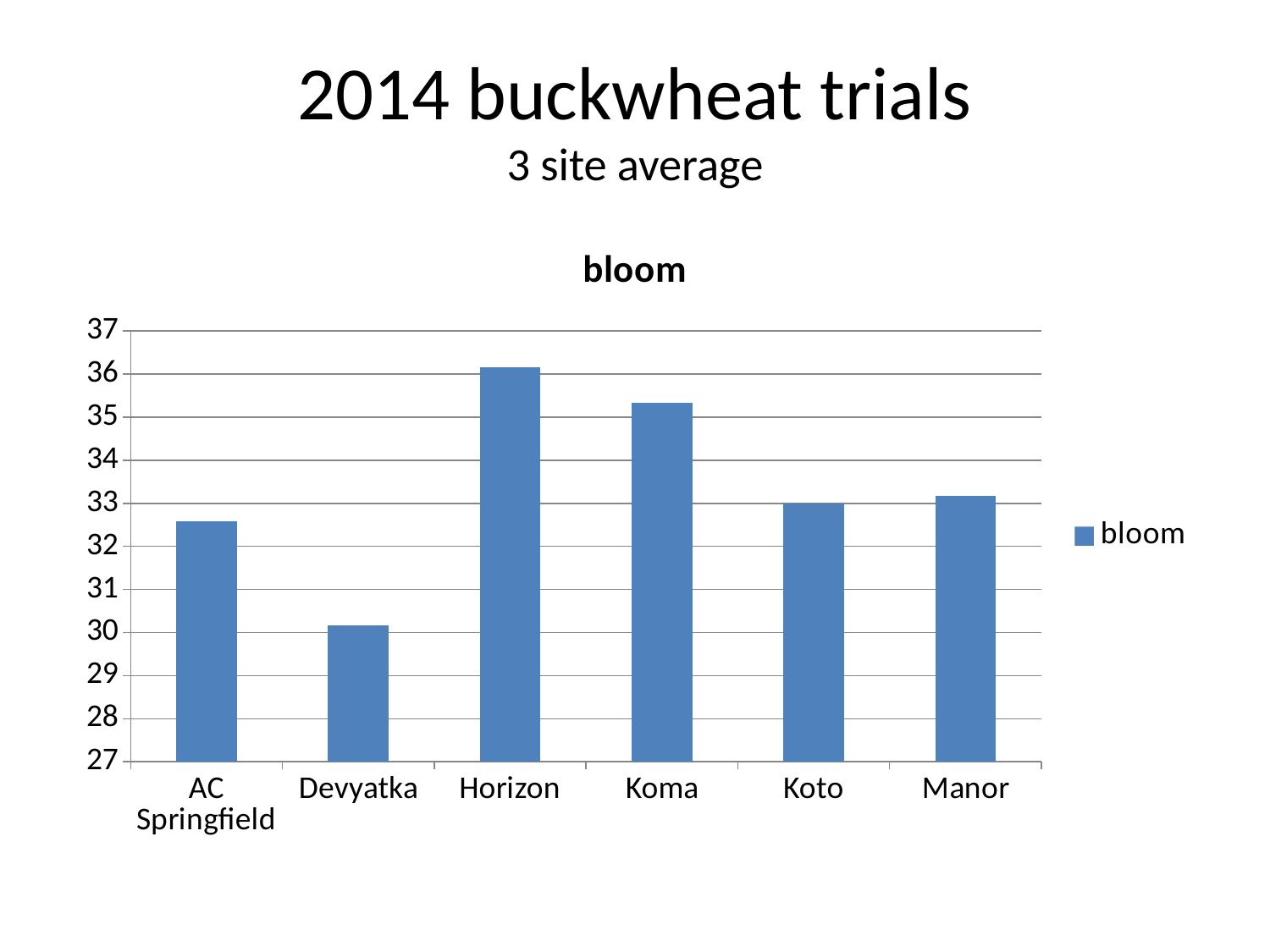
Which has a higher bloom value, Koma or Koto? Koma Which variety has the lowest bloom value? Devyatka Which variety has the highest bloom value? Horizon How many varieties (categories) are shown on the x axis of the chart? 6 What is the bloom value for Koto? 33 Is the bloom value for Manor greater or less than 34? less What is the title of the chart? bloom Is the bloom value for AC Springfield greater or less than 32? greater What type of chart is shown on the slide? bar chart Is the bloom value for Horizon greater or less than 35? greater How many series does the chart legend list? 1